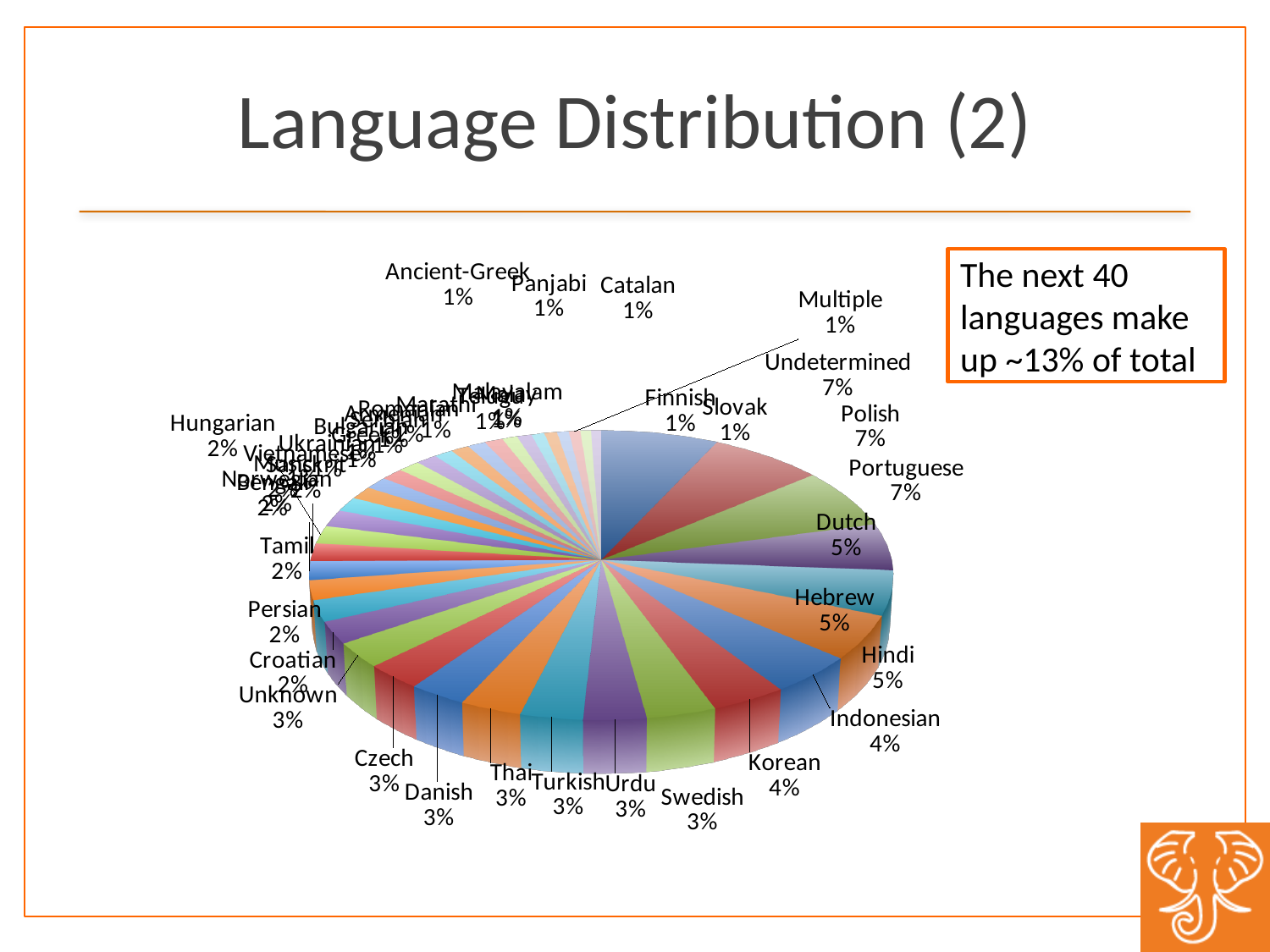
What is the difference between the shares of Portuguese and Hebrew? 2% What is the title of the slide containing the pie chart? Language Distribution (2) What type of chart is shown on the slide? pie chart According to the text box next to the chart, roughly what share of the total do the next 40 languages make up? ~13% What percentage is shown for Czech? 3% Which has the larger share, Undetermined or Hindi? Undetermined What percentage is shown for Hungarian? 2% Which has the larger share, Korean or Persian? Korean What percentage is shown for Dutch? 5% What percentage is shown for Catalan? 1% What share of the pie does Polish account for? 7% What percentage is shown for Indonesian? 4%